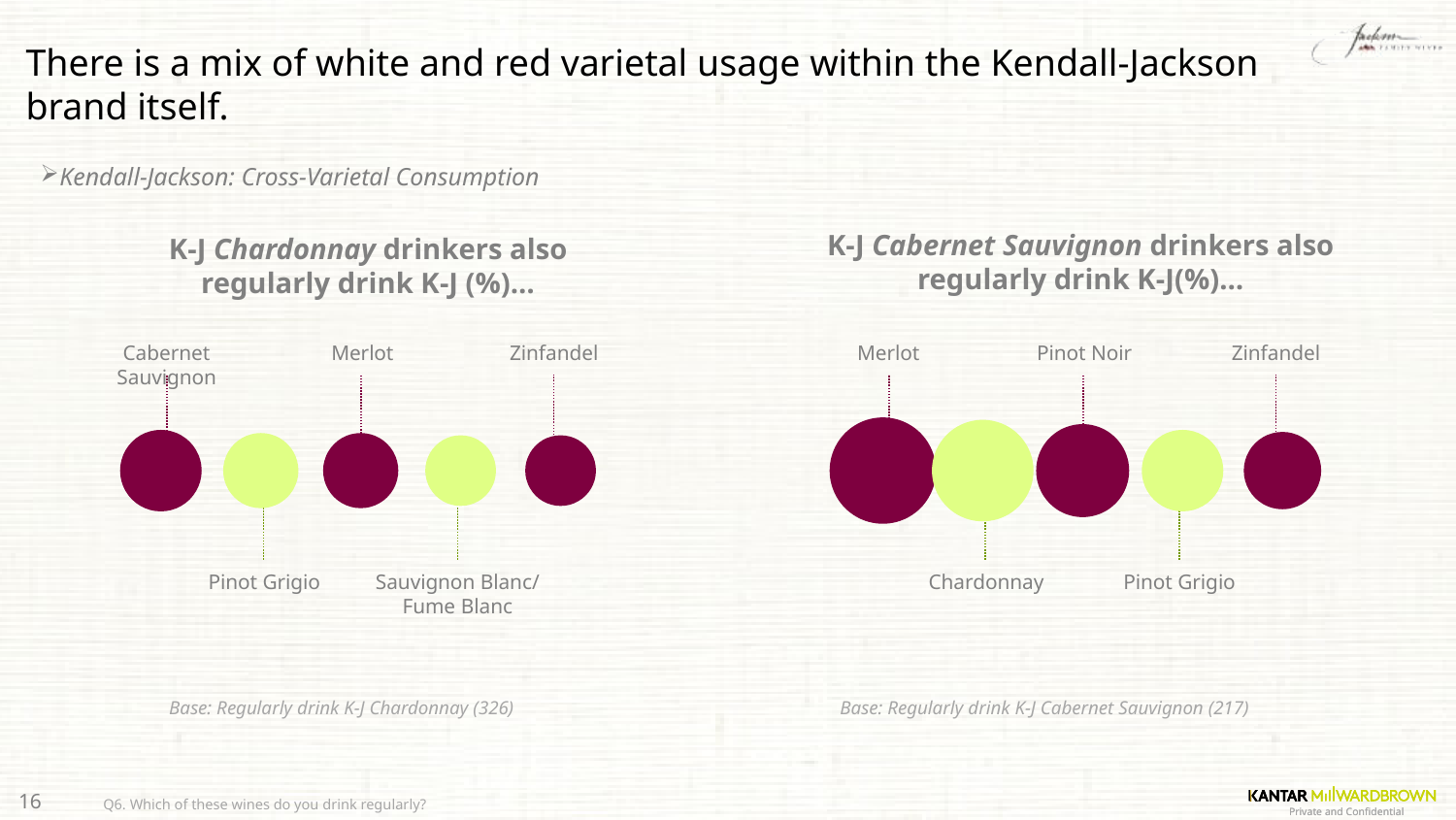
In the left chart (K-J Chardonnay drinkers), which varietals are shown in light green bubbles? Pinot Grigio and Sauvignon Blanc/Fume Blanc In the right chart (K-J Cabernet Sauvignon drinkers), how many other K-J varietals are shown? 5 In the left chart (K-J Chardonnay drinkers), how many other K-J varietals are shown? 5 In the right chart (K-J Cabernet Sauvignon drinkers), which varietals are labelled along the top of the bubbles? Merlot, Pinot Noir, Zinfandel In the left chart (K-J Chardonnay drinkers), which bubble is larger: Cabernet Sauvignon or Zinfandel? Cabernet Sauvignon What kind of chart is used on this slide to show cross-varietal consumption? Bubble chart In the right chart (K-J Cabernet Sauvignon drinkers), which bubble is larger: Chardonnay or Pinot Grigio? Chardonnay In the right chart (K-J Cabernet Sauvignon drinkers), which bubble is larger: Merlot or Zinfandel? Merlot In the right chart (K-J Cabernet Sauvignon drinkers), which varietal has the largest bubble? Merlot What is the base size for the K-J Chardonnay drinkers chart? 326